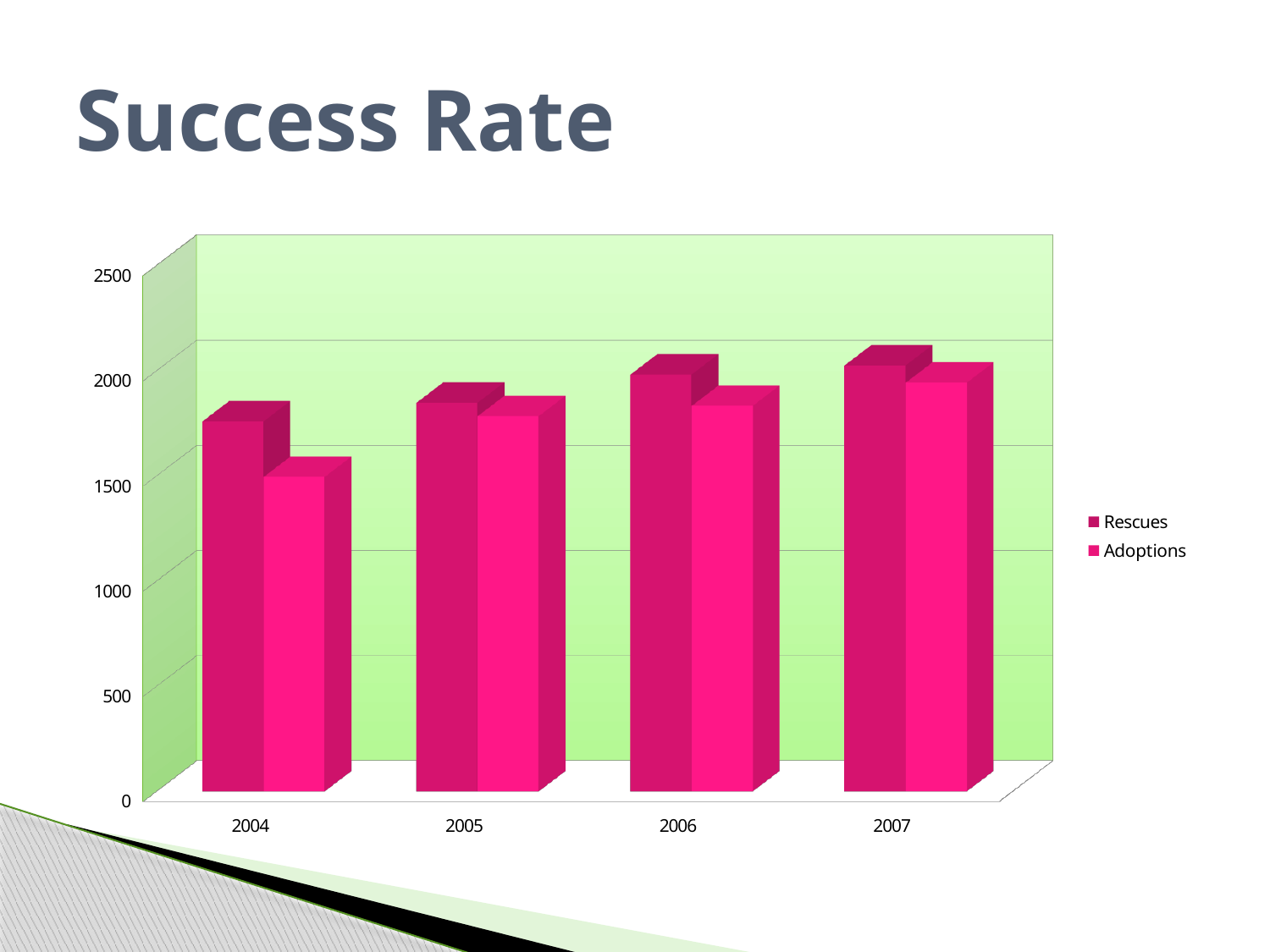
What are the two series named in the legend? Rescues and Adoptions How many years are shown on the x axis? 4 What is the title of the chart? Success Rate In which year is the Rescues value lowest? 2004 Is the Rescues value for 2005 greater or less than 1500? greater How many series does the legend list? 2 Do the Adoptions values rise or fall from 2004 to 2007? rise What kind of chart is shown on the slide? bar chart Is the Rescues value for 2004 greater or less than 2000? less In 2004, which is larger, Rescues or Adoptions? Rescues In which year is the Adoptions value lowest? 2004 Is the Adoptions value for 2004 greater or less than 2000? less